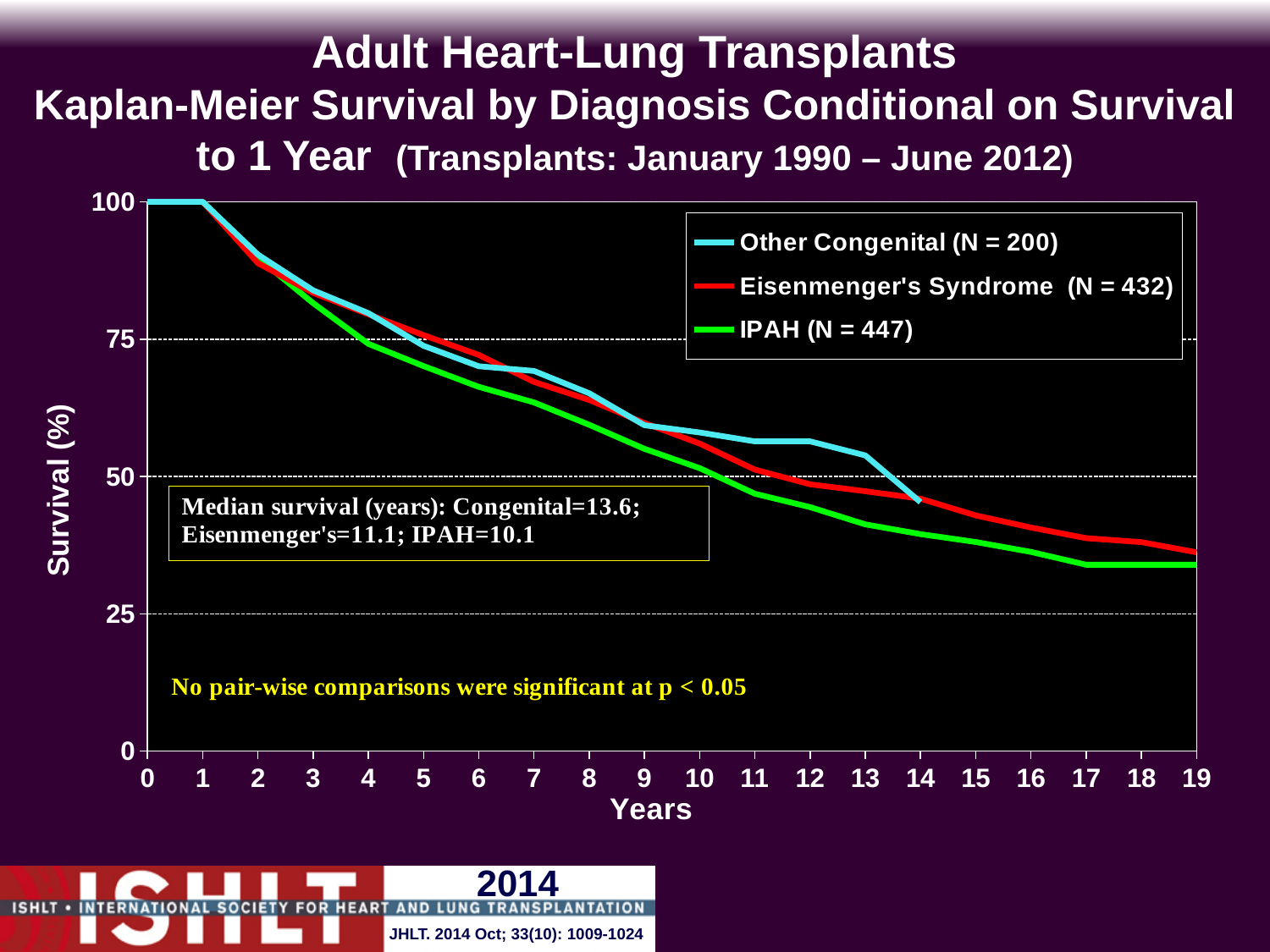
Do the survival curves rise or fall as years increase? fall What is the median survival in years for IPAH, as stated on the slide? 10.1 What is the median survival in years for Eisenmenger's, as stated on the slide? 11.1 What is the median survival in years for the Congenital group, as stated on the slide? 13.6 Is the survival for Other Congenital at 12 years greater or less than 50? greater What kind of chart is shown on the slide? line chart How many series does the legend list? 3 Is the survival for IPAH at 17 years greater or less than 50? less Which diagnosis group has the highest median survival according to the text box? Congenital At 12 years, which series has higher survival: Other Congenital or IPAH? Other Congenital What is the difference in median survival (years) between Congenital and IPAH? 3.5 Which diagnosis group has the lowest median survival according to the text box? IPAH